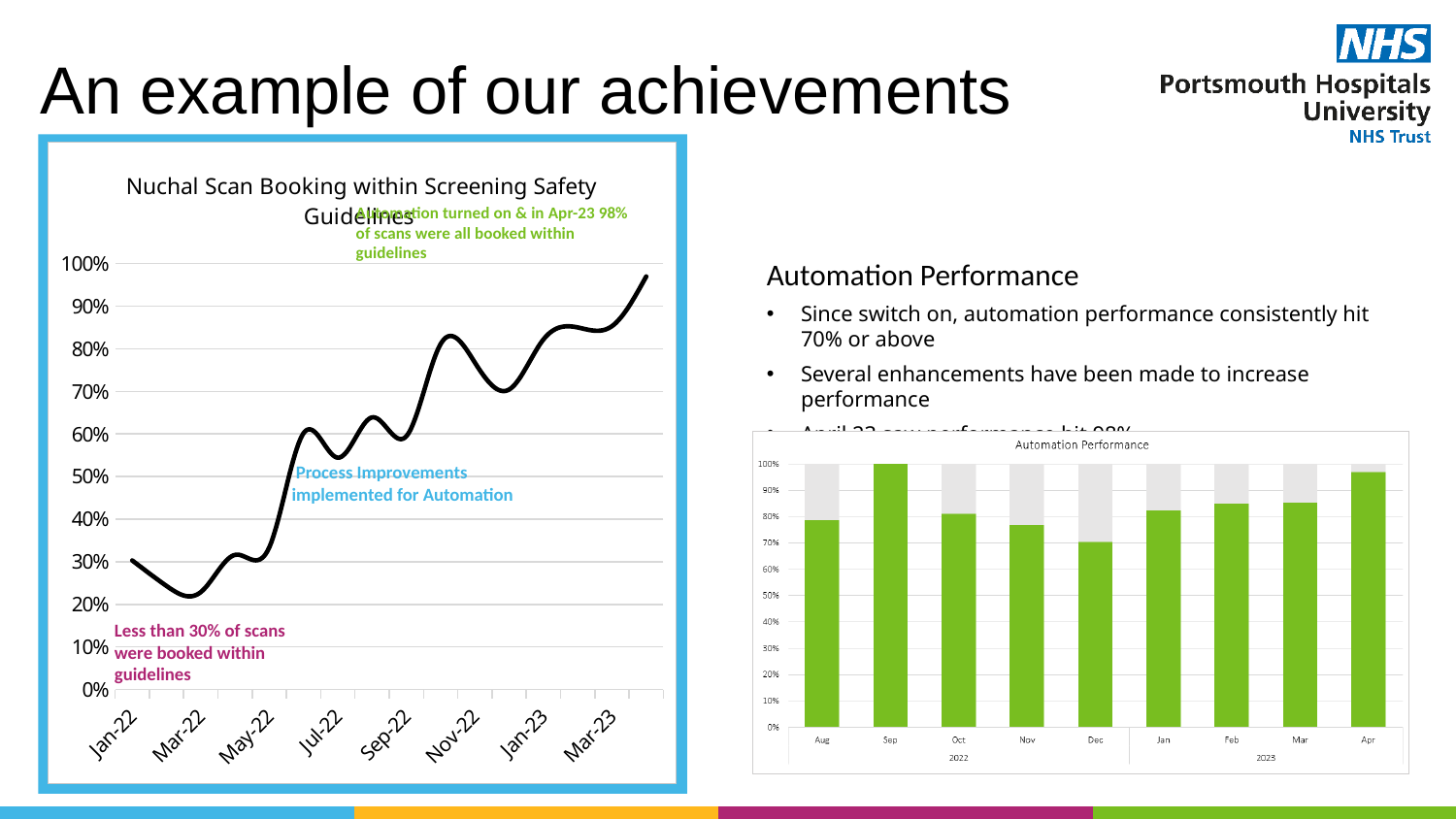
In the 'Nuchal Scan Booking within Screening Safety Guidelines' chart, do the values generally rise or fall from Jan-22 to Mar-23? Rise In the 'Automation Performance' chart, is the value for Dec greater or less than 80%? less In the 'Automation Performance' chart, how many months are plotted? 9 In the 'Automation Performance' chart, which month has the lowest green bar? Dec In the 'Automation Performance' chart, which is larger, the value for Apr or the value for Dec? Apr In the 'Automation Performance' chart, is the value for Apr greater or less than 90%? greater What is the title of the chart on the right of the slide? Automation Performance What kind of chart is the 'Nuchal Scan Booking within Screening Safety Guidelines' chart on the left? Line chart In the 'Nuchal Scan Booking within Screening Safety Guidelines' chart, is the value at Mar-23 greater or less than 80%? greater What kind of chart is the 'Automation Performance' chart on the right? Bar chart In the 'Automation Performance' chart, which month has the highest green bar? Sep